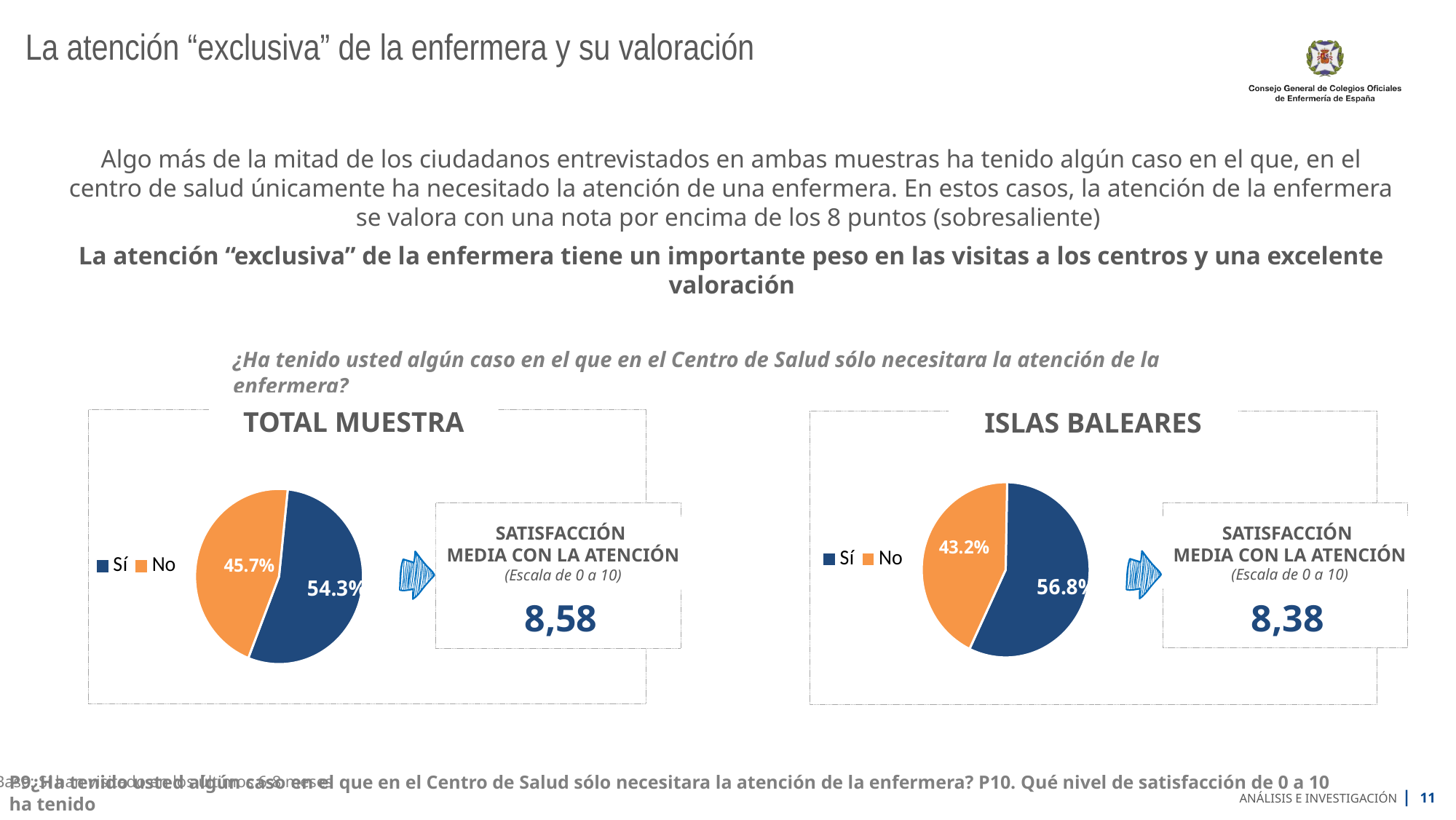
In the ISLAS BALEARES pie chart, what is the difference between the Sí and No percentages? 13.6% In the TOTAL MUESTRA pie chart, what percentage answered Sí? 54.3% In the TOTAL MUESTRA pie chart, what percentage answered No? 45.7% How many entries does the legend of the TOTAL MUESTRA pie chart list? 2 What type of chart is used for TOTAL MUESTRA? Pie chart In the TOTAL MUESTRA pie chart, which slice is the largest? Sí In the TOTAL MUESTRA pie chart, what is the difference between the Sí and No percentages? 8.6% In the ISLAS BALEARES pie chart, what percentage answered No? 43.2% In the ISLAS BALEARES pie chart, what colour is the Sí slice? Dark blue In the ISLAS BALEARES pie chart, which slice is larger, Sí or No? Sí How many slices does the ISLAS BALEARES pie chart have? 2 In the ISLAS BALEARES pie chart, what percentage answered Sí? 56.8%